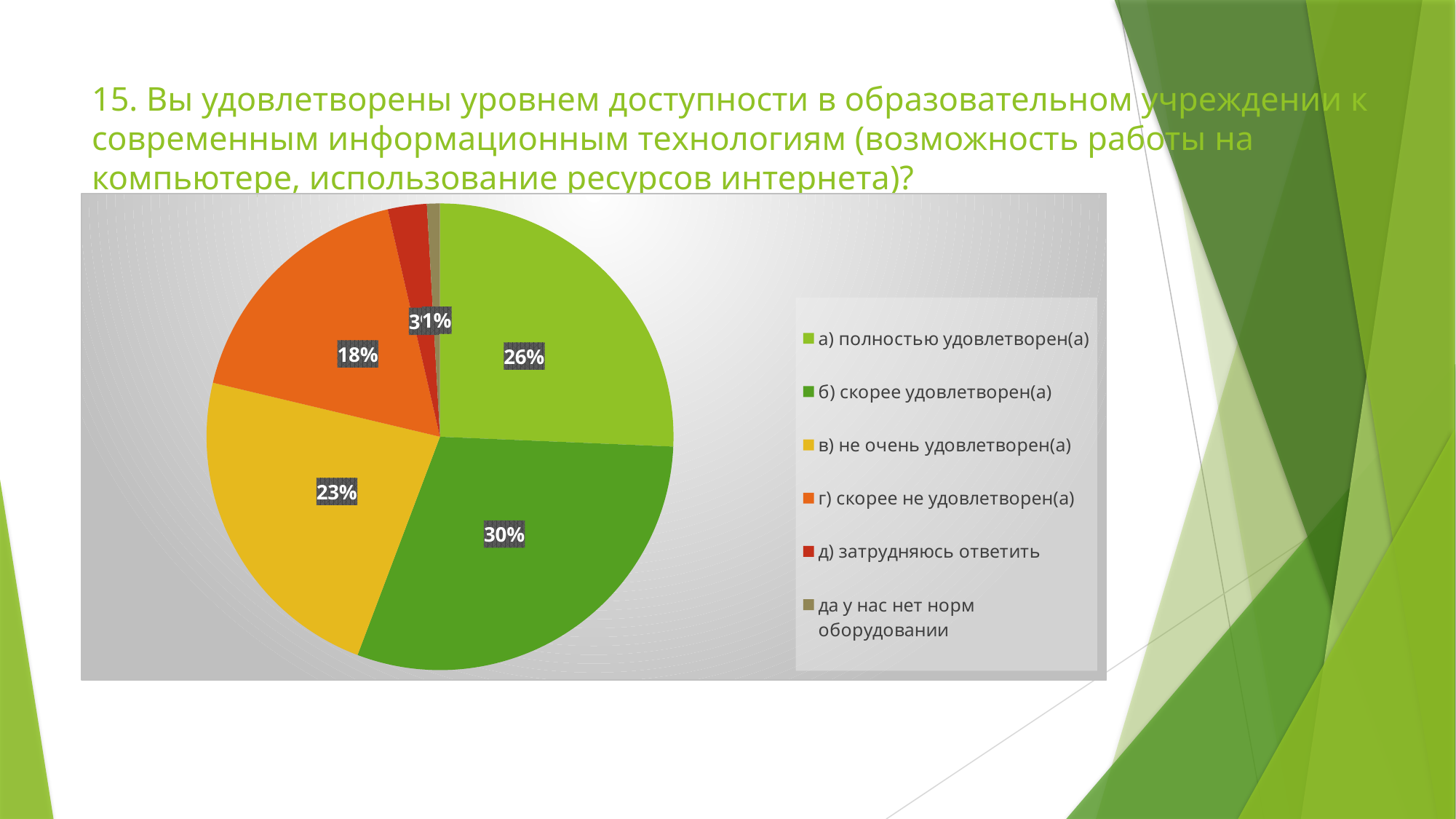
What percentage of respondents chose "г) скорее не удовлетворен(а)"? 18% By how many percentage points does "б) скорее удовлетворен(а)" exceed "а) полностью удовлетворен(а)"? 4 percentage points What is the difference between the shares for "в) не очень удовлетворен(а)" and "г) скорее не удовлетворен(а)"? 5 percentage points Which answer option has the smallest share of the pie? да у нас нет норм оборудовании What percentage of respondents chose "б) скорее удовлетворен(а)"? 30% Which is larger: the share for "а) полностью удовлетворен(а)" or for "в) не очень удовлетворен(а)"? а) полностью удовлетворен(а) What percentage of respondents chose "в) не очень удовлетворен(а)"? 23% What is the combined share of "а) полностью удовлетворен(а)" and "б) скорее удовлетворен(а)"? 56% What type of chart is shown on the slide? Pie chart What percentage of respondents chose "а) полностью удовлетворен(а)"? 26% How many answer options are listed in the legend? 6 Which answer option has the largest share of the pie? б) скорее удовлетворен(а)